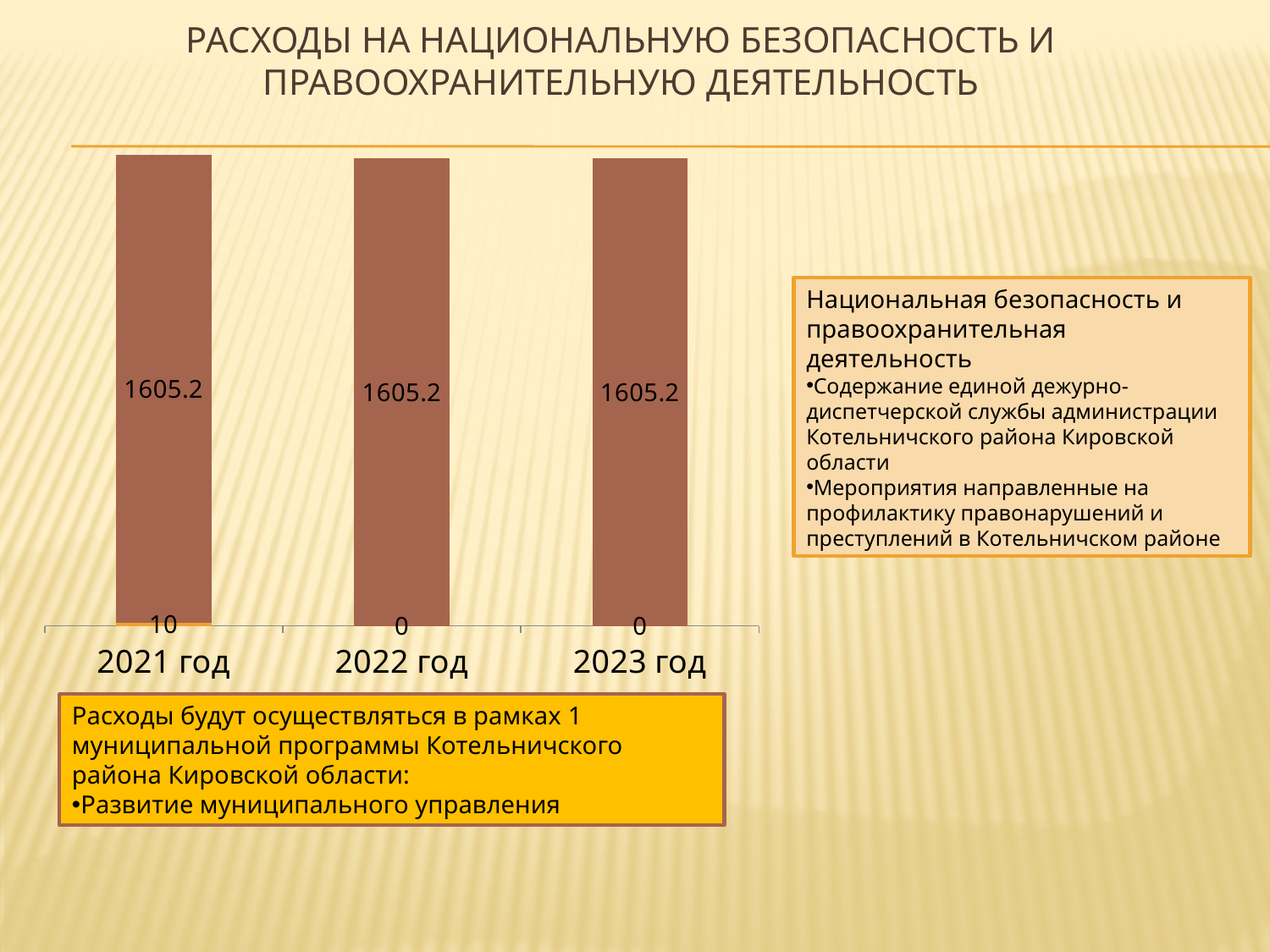
How many year categories are shown on the x axis of the chart? 3 What is the difference between the small-segment values for 2021 год and 2022 год? 10 What value is printed at the base of the 2022 год bar for the small segment? 0 What is the title of the slide containing the chart? РАСХОДЫ НА НАЦИОНАЛЬНУЮ БЕЗОПАСНОСТЬ И ПРАВООХРАНИТЕЛЬНУЮ ДЕЯТЕЛЬНОСТЬ What value is printed at the base of the 2021 год bar for the small orange segment? 10 Do the values of the large brown bars rise, fall, or stay the same from 2021 год to 2023 год? stay the same What value is printed at the base of the 2023 год bar for the small segment? 0 What kind of chart is shown on the slide? bar chart What is the total of the stacked bar for 2021 год (1605.2 plus 10)? 1615.2 What is the value of the large brown bar for 2022 год? 1605.2 What is the value of the large brown bar for 2021 год? 1605.2 What is the value of the large brown bar for 2023 год? 1605.2